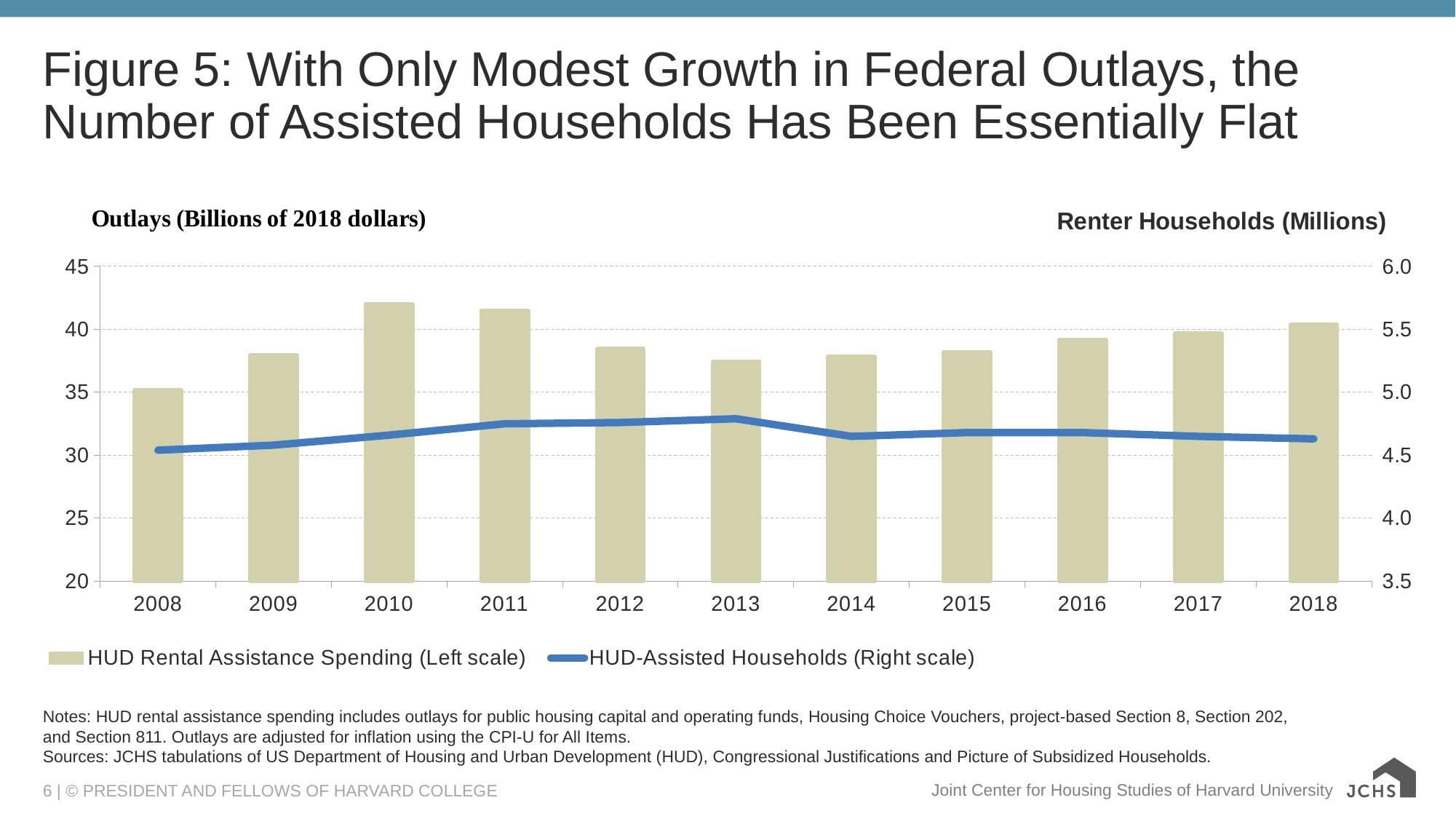
How many series does the legend list? 2 Is the HUD Rental Assistance Spending value for 2013 greater or less than 40? less Is the HUD Rental Assistance Spending value for 2010 greater or less than 40? greater Which is larger, HUD Rental Assistance Spending in 2010 or in 2013? 2010 What is the label of the left vertical axis? Outlays (Billions of 2018 dollars) How many years are shown on the x axis? 11 Which year has the lowest HUD Rental Assistance Spending bar? 2008 Which is larger, HUD Rental Assistance Spending in 2009 or in 2018? 2018 Is the HUD-Assisted Households value for 2013 greater or less than 5.0 million? less Do the HUD Rental Assistance Spending bars rise or fall from 2013 to 2018? rise What kind of chart is shown on the slide? A combined bar and line chart